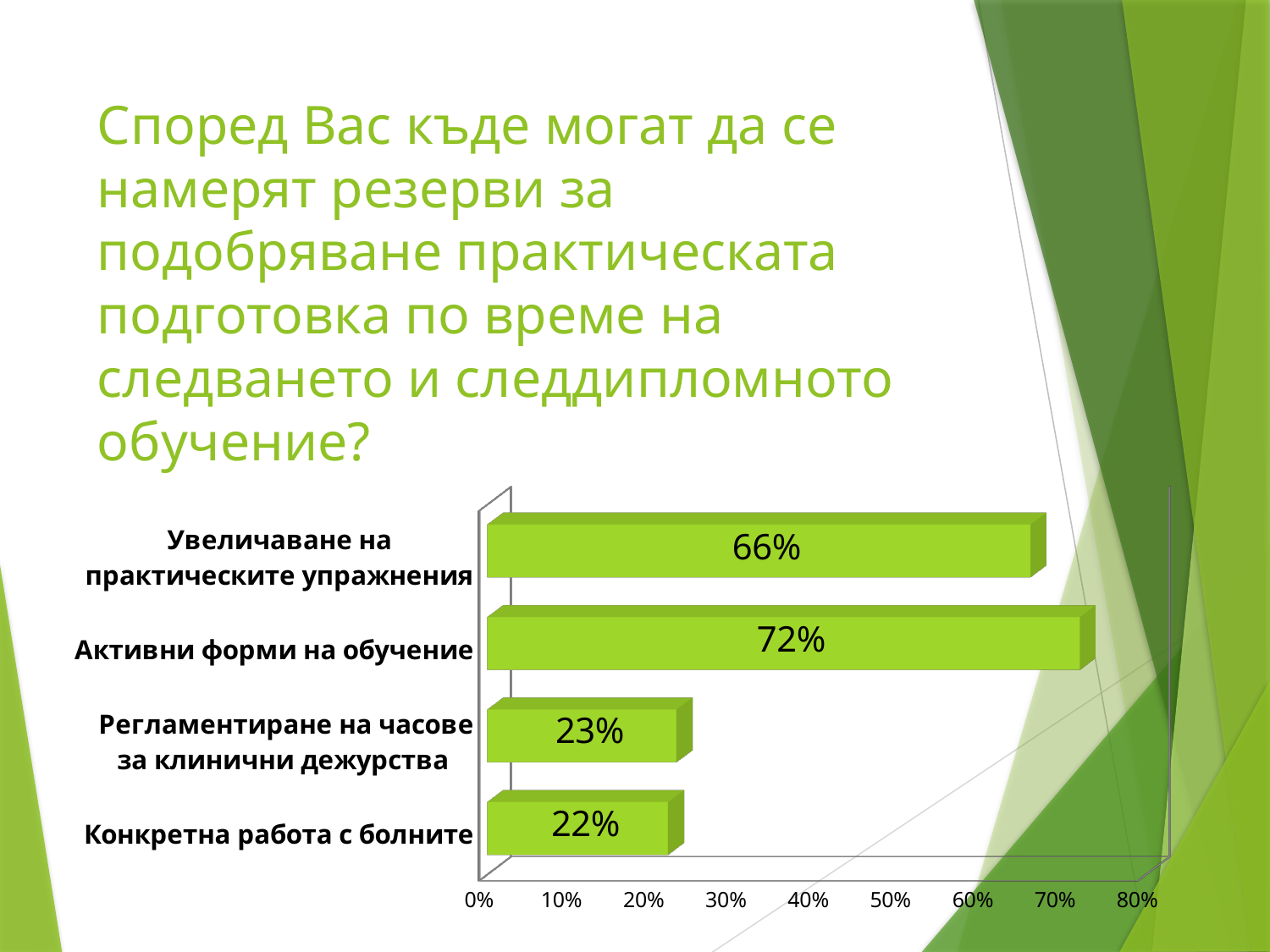
What is the value for "Регламентиране на часове за клинични дежурства"? 23% What is the highest value shown on the horizontal axis? 80% What kind of chart is shown on the slide? bar chart What is the difference between the values for "Активни форми на обучение" and "Увеличаване на практическите упражнения"? 6% Which is larger: the value for "Регламентиране на часове за клинични дежурства" or for "Конкретна работа с болните"? Регламентиране на часове за клинични дежурства Which category has the highest value? Активни форми на обучение Which category has the lowest value? Конкретна работа с болните What is the value for "Увеличаване на практическите упражнения"? 66% Is the value for "Увеличаване на практическите упражнения" greater or less than 50%? greater What is the value for "Конкретна работа с болните"? 22% How many categories are shown in the chart? 4 What is the value for "Активни форми на обучение"? 72%